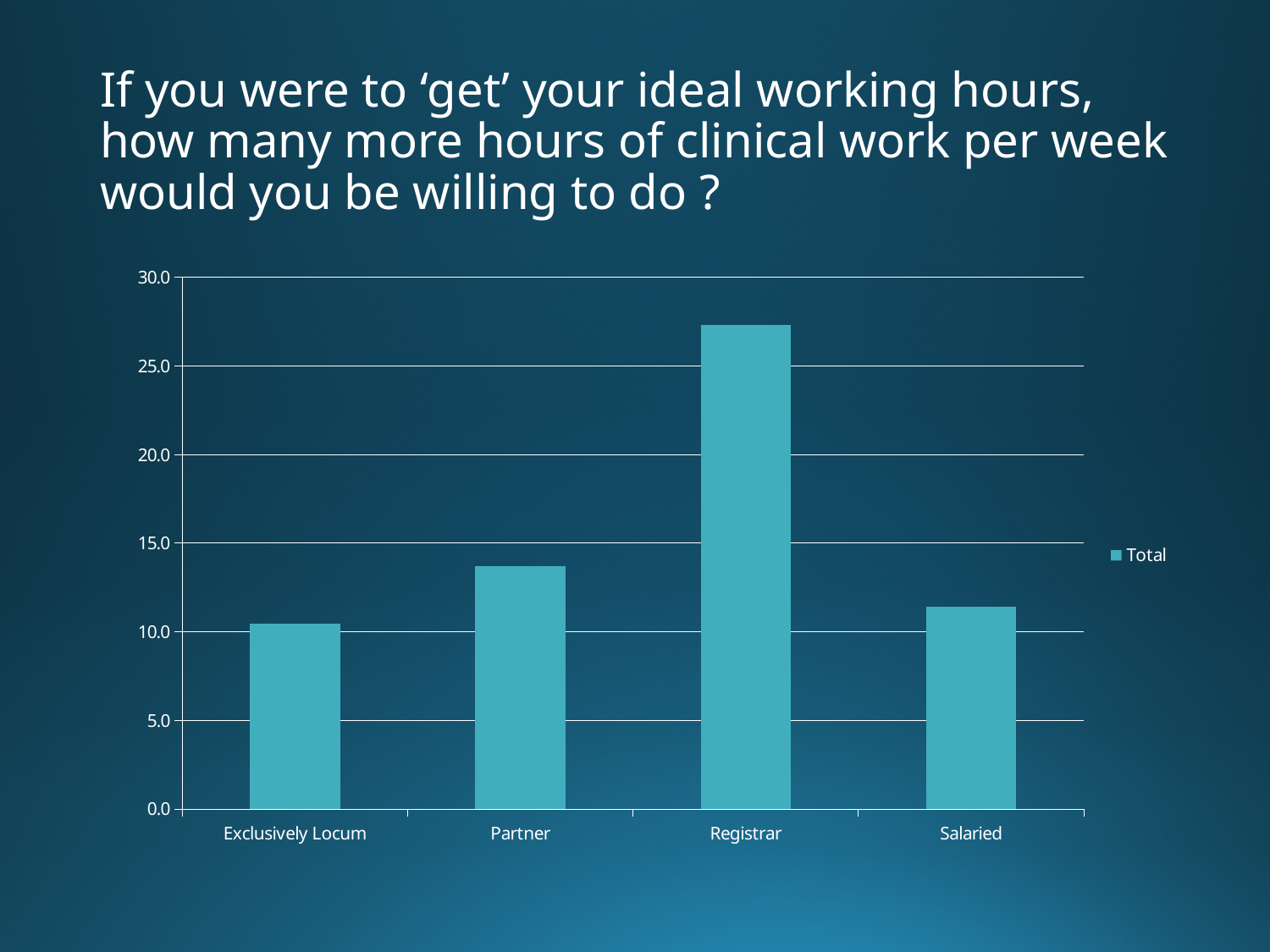
What is the name of the series shown in the legend? Total How many categories are shown on the x axis? 4 How many series does the legend list? 1 Which is larger, the value for Registrar or the value for Exclusively Locum? Registrar Is the value for Registrar greater or less than 25.0? greater Is the value for Salaried greater or less than 10.0? greater Is the value for Partner greater or less than 15.0? less Which category has the highest value? Registrar Which is larger, the value for Partner or the value for Salaried? Partner What kind of chart is shown on the slide? bar chart Which category has the lowest value? Exclusively Locum